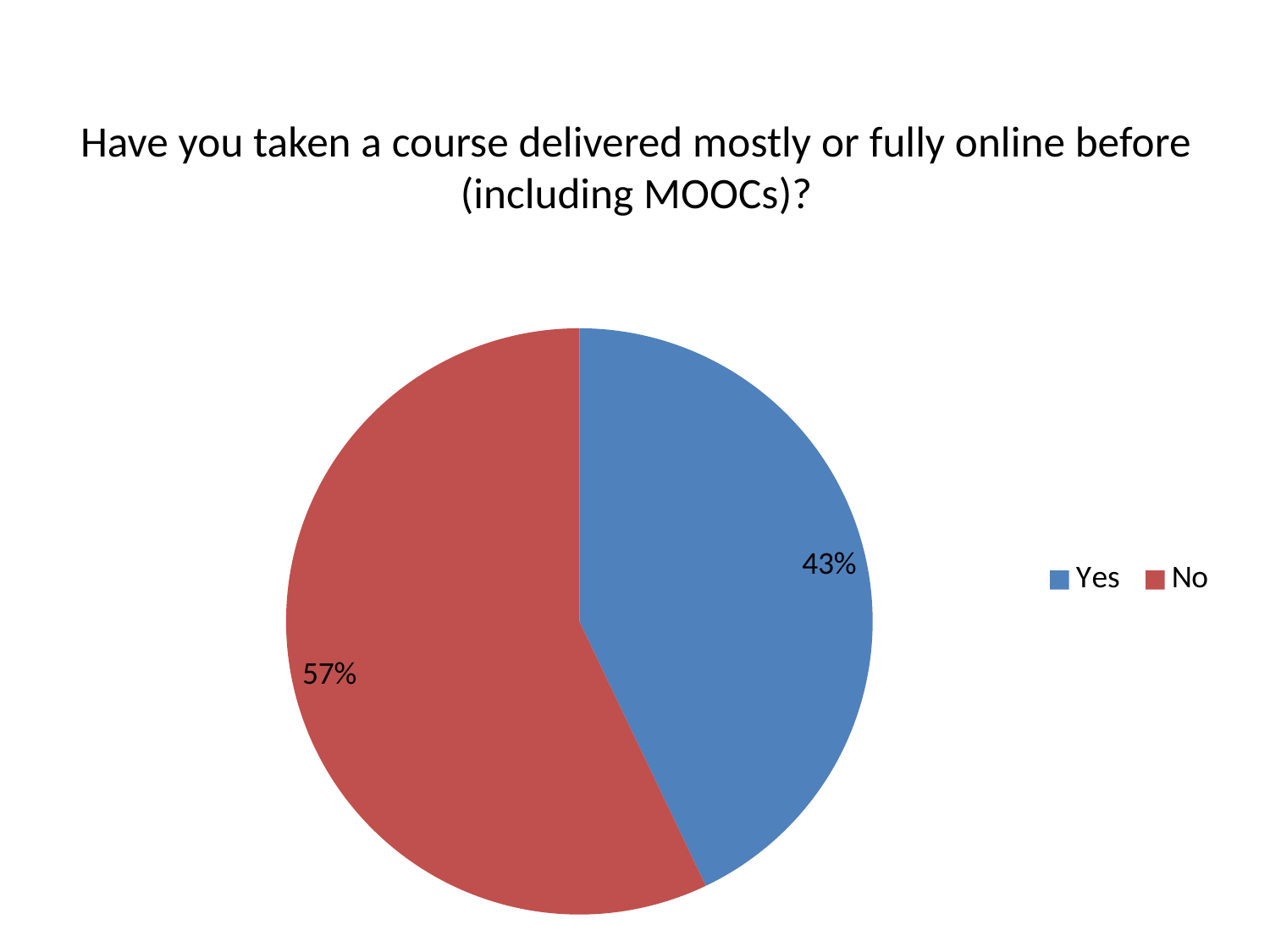
Which slice is larger, Yes or No? No What colour is the No slice? Red How many slices does the pie chart have? 2 What share of the pie does the Yes slice represent? 43% Which response has the smallest share of the pie? Yes What percentage of respondents answered Yes? 43% What is the title of the chart? Have you taken a course delivered mostly or fully online before (including MOOCs)? How many entries does the legend list? 2 What is the difference in percentage points between the No and Yes slices? 14 Which response has the largest share of the pie? No What kind of chart is shown on the slide? Pie chart What percentage of respondents answered No? 57%